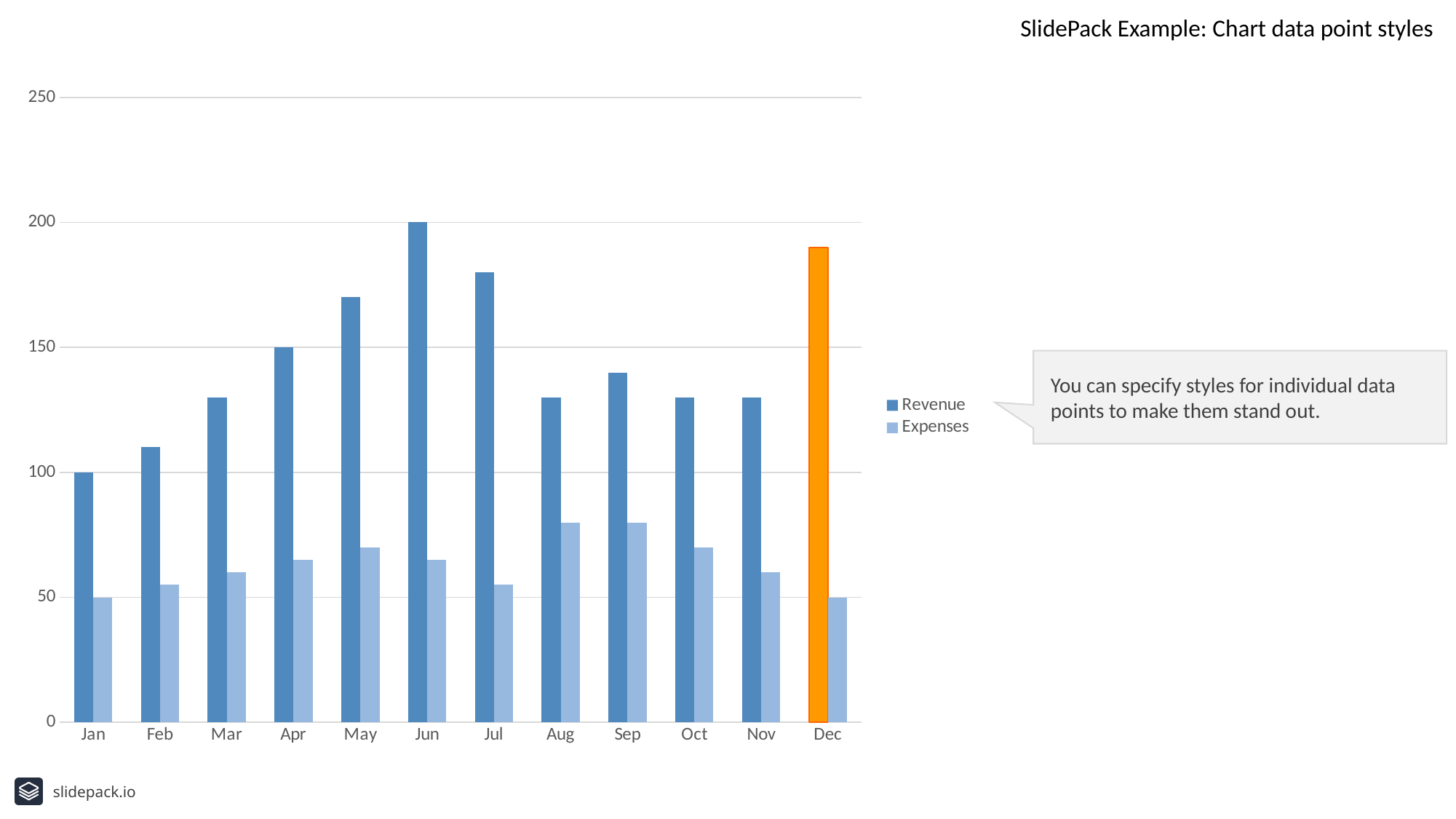
What is the Revenue value for Jan? 100 What kind of chart is shown on the slide? bar chart Is the Expenses value for Jul greater or less than 100? less How many series does the legend list? 2 What is the Revenue value for Jun? 200 Which data point is highlighted in orange? Dec Revenue Is the Revenue value for Dec greater or less than 150? greater Which is larger, the Revenue for Jun or the Revenue for Jul? Jun Which month has the highest Revenue? Jun What is the difference between the Revenue for Jun and the Revenue for Jan? 100 Which month has the lowest Revenue? Jan How many months are shown on the x axis? 12